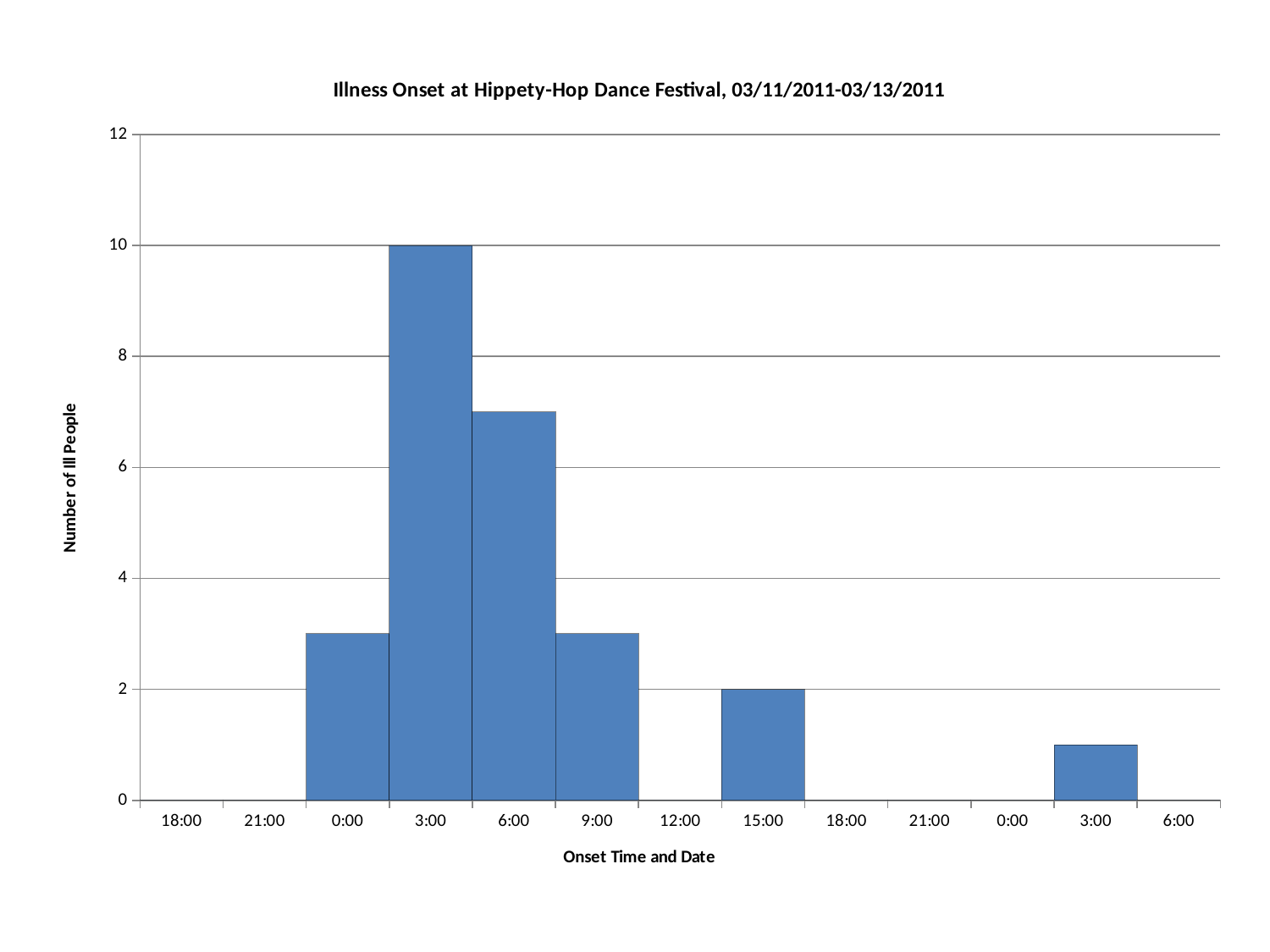
Which onset time has the highest number of ill people? 3:00 (the first one) Is the number of ill people at the second 3:00 greater or less than 2? less What type of chart is shown on the slide? bar chart Which onset time has the lowest non-zero number of ill people? 3:00 (the second one) How many bars are plotted in the chart? 6 Is the number of ill people at 6:00 greater or less than 6? greater What is the title of the chart? Illness Onset at Hippety-Hop Dance Festival, 03/11/2011-03/13/2011 What is the label of the vertical axis? Number of Ill People What is the number of ill people for the bar at 15:00? 2 What is the difference between the number of ill people at the first 3:00 and at 15:00? 8 Which has more ill people, the bar at 6:00 or the bar at 9:00? 6:00 What is the number of ill people for the tallest bar, at the first 3:00 on the x axis? 10